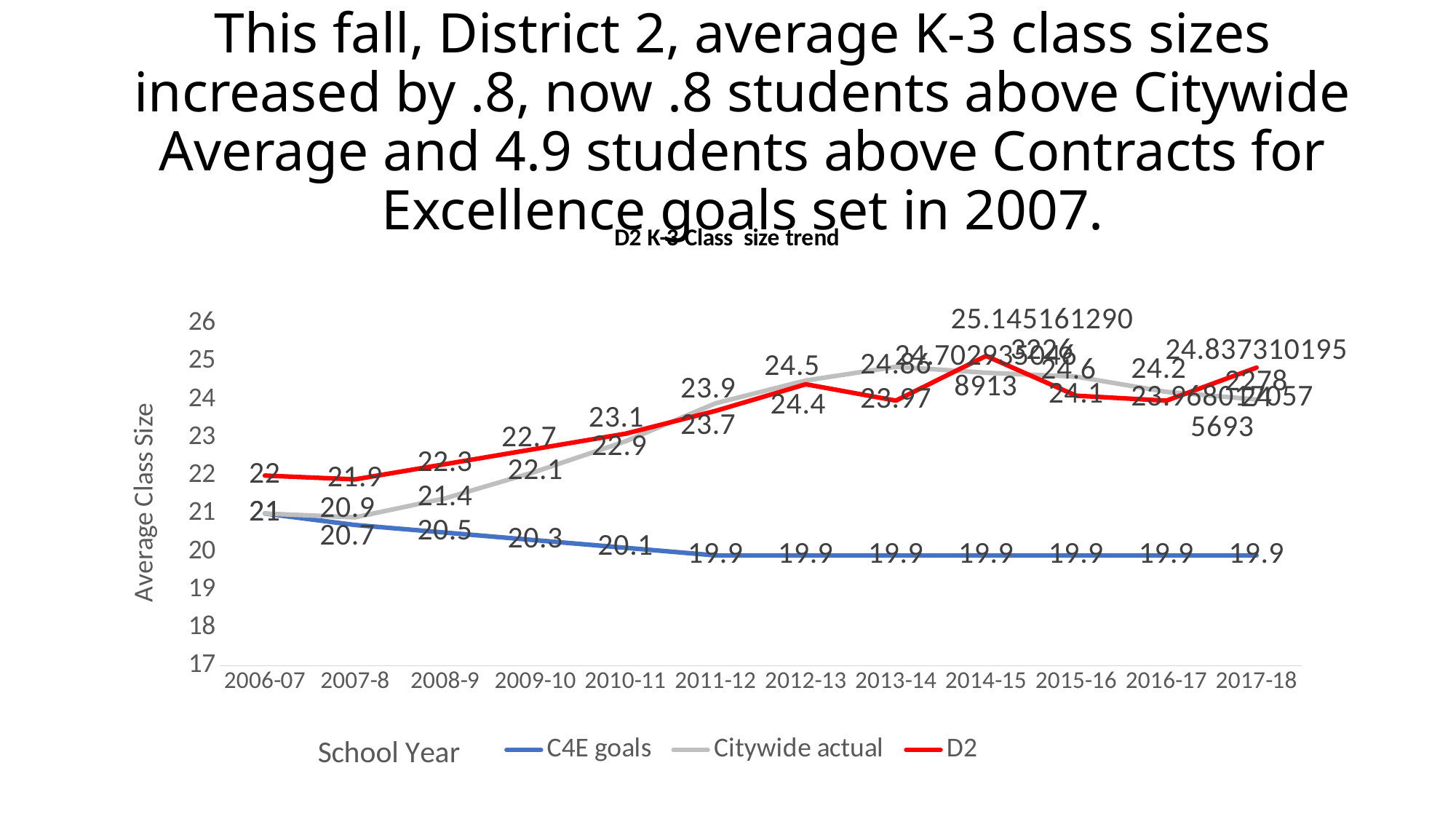
What is the D2 value for 2012-13? 24.4 How many series does the legend list? 3 What is the difference between the D2 value and the C4E goals value in 2006-07? 1 Do the C4E goals values rise or fall from 2006-07 to 2011-12? fall Which is larger in 2007-8, the D2 value or the Citywide actual value? D2 How many school years are plotted on the x axis? 12 What is the lowest value of the C4E goals series? 19.9 What kind of chart is shown on the slide? line chart In which school year does the D2 series reach its highest value? 2014-15 What is the Citywide actual value for 2010-11? 22.9 What is the C4E goals value for 2007-8? 20.7 What is the D2 value for 2009-10? 22.7